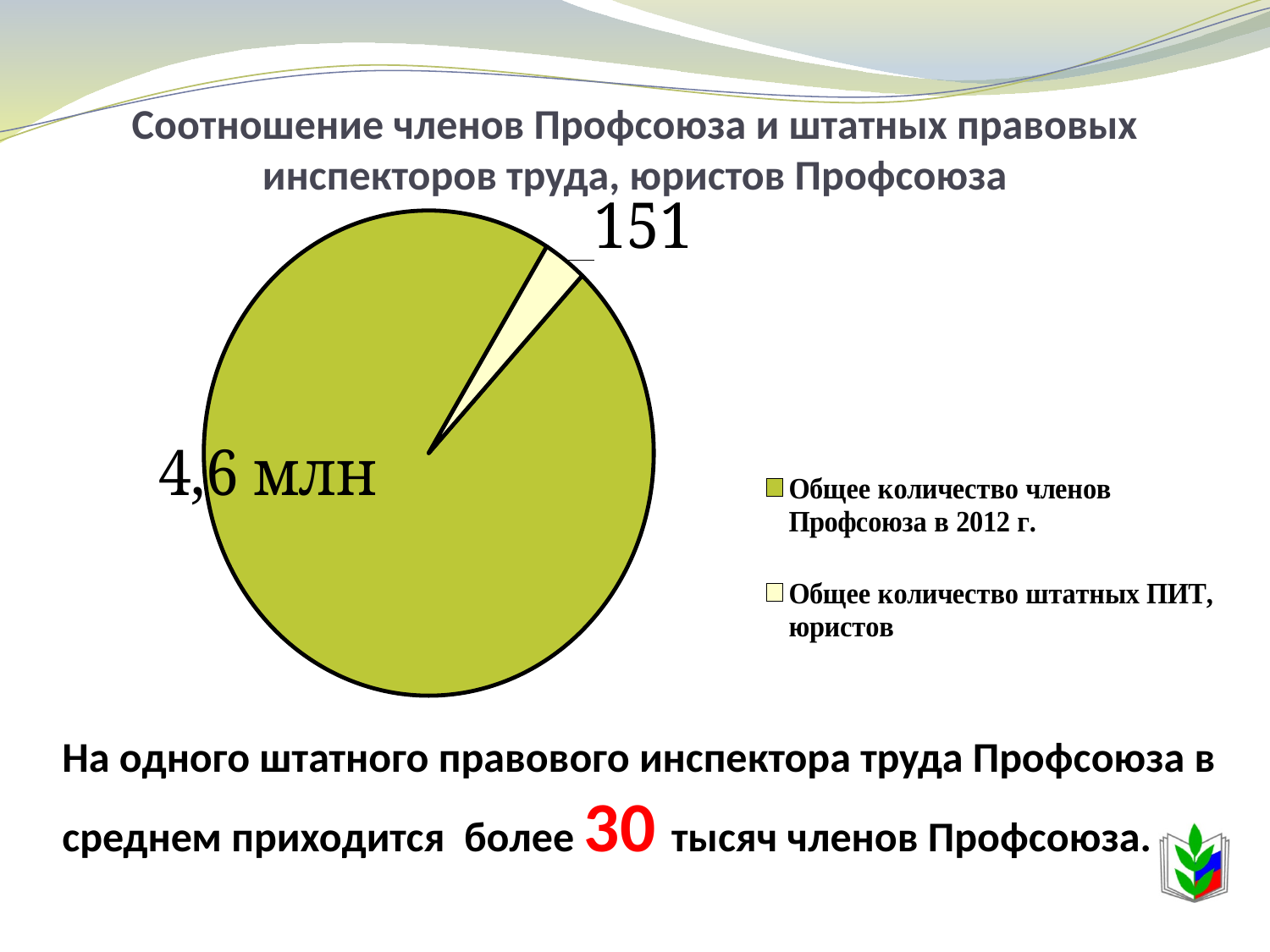
What is the title of the chart on the slide? Соотношение членов Профсоюза и штатных правовых инспекторов труда, юристов Профсоюза How many slices does the pie chart have? 2 What kind of chart is shown on the slide? pie chart Which is larger: the number of Profsoyuz members in 2012 or the number of staff legal inspectors and lawyers? Общее количество членов Профсоюза в 2012 г. Which category has the largest slice in the pie chart? Общее количество членов Профсоюза в 2012 г. What value is shown for "Общее количество штатных ПИТ, юристов"? 151 What colour is the slice for "Общее количество штатных ПИТ, юристов"? pale yellow What value is shown for "Общее количество членов Профсоюза в 2012 г."? 4,6 млн Which category has the smallest slice in the pie chart? Общее количество штатных ПИТ, юристов How many entries does the legend of the pie chart list? 2